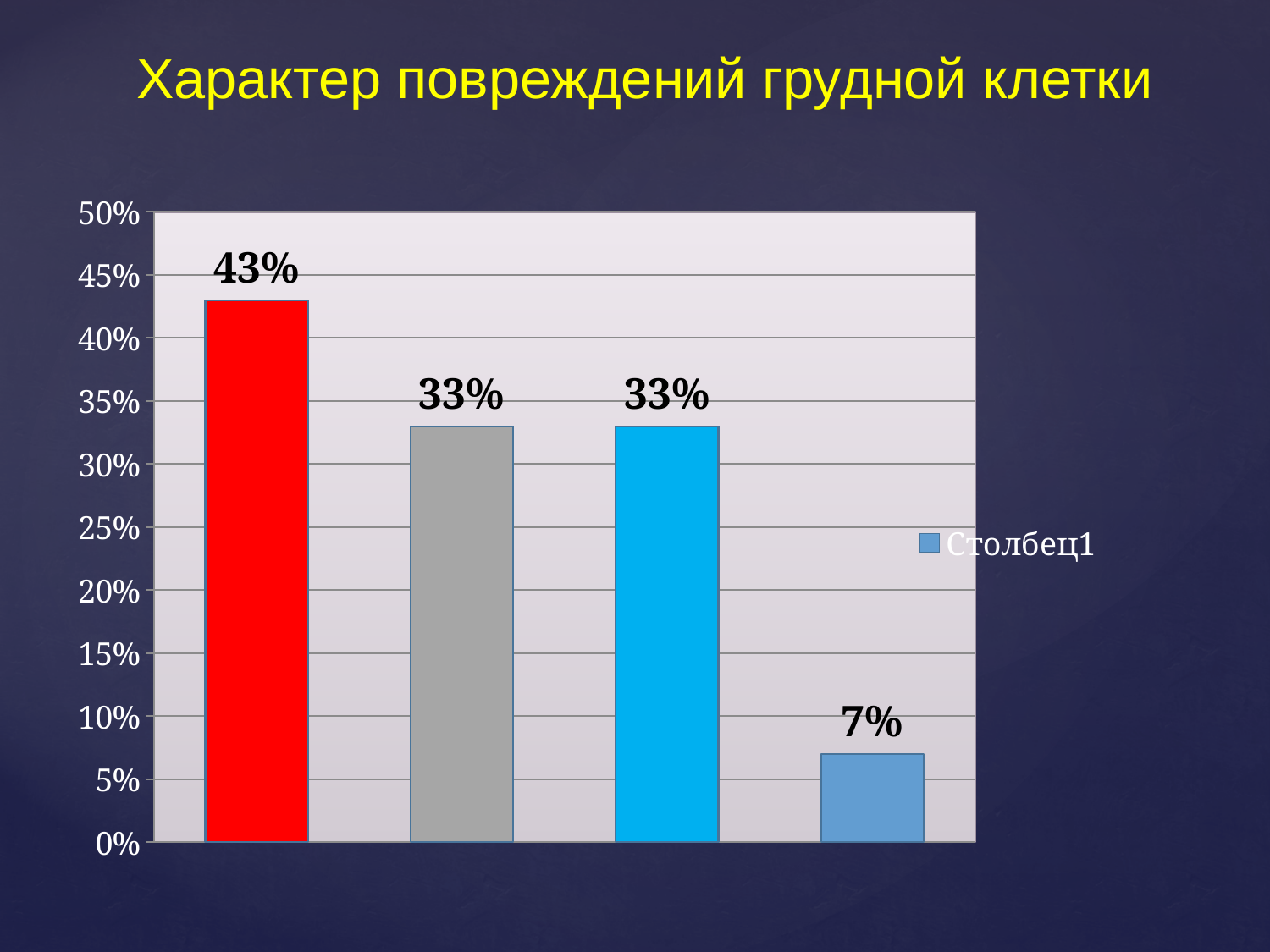
Is the value of the red bar greater or less than 40%? greater What is the difference between the value of the red bar and the value of the grey bar? 10% What is the difference between the value of the red bar and the value of the rightmost bar? 36% What is the title of the slide? Характер повреждений грудной клетки Which bar has the highest value? The red bar (first from the left), 43% How many bars are plotted in the chart? 4 Which bar has the lowest value? The rightmost bar, 7% What type of chart is shown on the slide? Bar chart Which is larger, the value of the grey bar or the value of the rightmost bar? The grey bar What is the value shown on the grey bar (second from the left)? 33% What is the value shown on the red bar (first from the left)? 43% What is the value shown on the rightmost bar? 7%